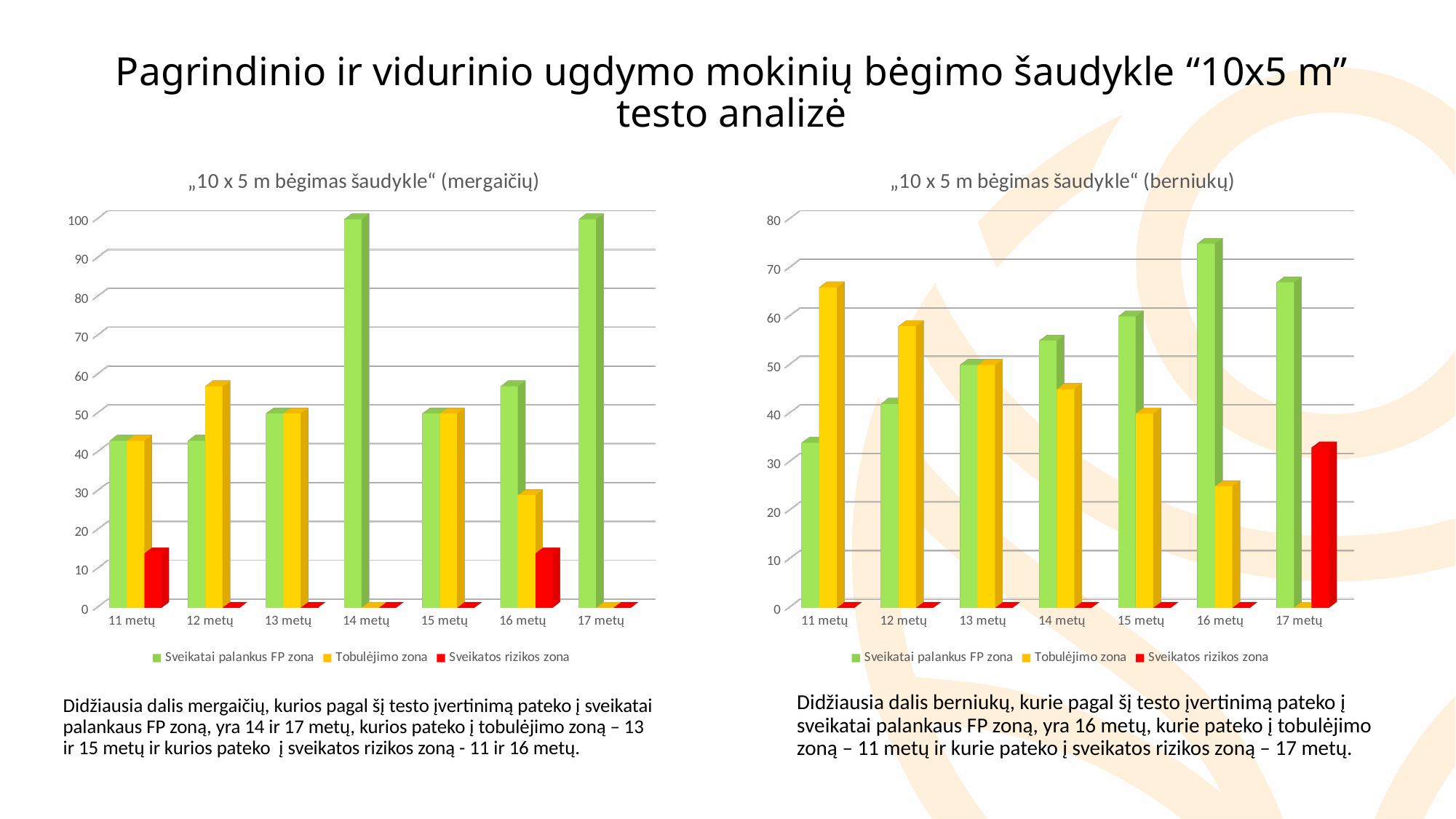
What kind of chart is the left chart, „10 x 5 m bėgimas šaudykle“ (mergaičių)? bar chart In the right chart, „10 x 5 m bėgimas šaudykle“ (berniukų), which age group has the lowest value for Sveikatai palankus FP zona? 11 metų In the right chart, „10 x 5 m bėgimas šaudykle“ (berniukų), which age group has the highest value for Tobulėjimo zona? 11 metų In the right chart, „10 x 5 m bėgimas šaudykle“ (berniukų), which age group has the highest value for Sveikatai palankus FP zona? 16 metų In the left chart, „10 x 5 m bėgimas šaudykle“ (mergaičių), what is the Sveikatai palankus FP zona value for 14 metų? 100 In the left chart, „10 x 5 m bėgimas šaudykle“ (mergaičių), is the Tobulėjimo zona value for 12 metų greater or less than 50? greater In the left chart, „10 x 5 m bėgimas šaudykle“ (mergaičių), is the Tobulėjimo zona value for 16 metų greater or less than 40? less In the left chart, „10 x 5 m bėgimas šaudykle“ (mergaičių), what colour represents Sveikatos rizikos zona in the legend? red In the right chart, „10 x 5 m bėgimas šaudykle“ (berniukų), for 14 metų, which is larger: Sveikatai palankus FP zona or Tobulėjimo zona? Sveikatai palankus FP zona How many age categories are shown on the x axis of the left chart, „10 x 5 m bėgimas šaudykle“ (mergaičių)? 7 In the right chart, „10 x 5 m bėgimas šaudykle“ (berniukų), is the Sveikatos rizikos zona value for 17 metų greater or less than 20? greater How many series does the legend of the right chart, „10 x 5 m bėgimas šaudykle“ (berniukų), list? 3